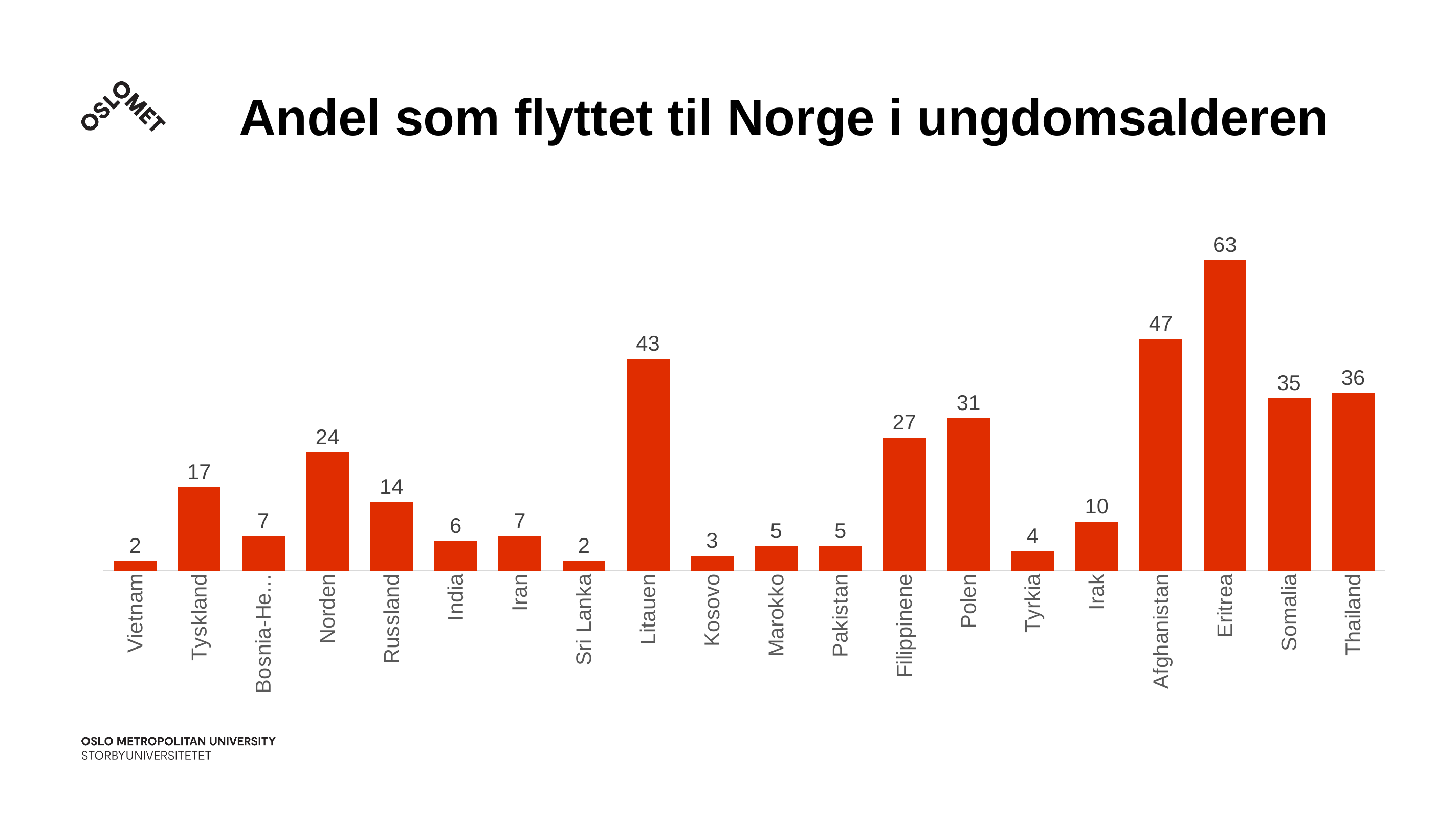
How many countries are shown on the x axis? 20 Which is larger, the value for Filippinene or the value for Polen? Polen What is the value for Litauen? 43 What is the difference between the values for Eritrea and Afghanistan? 16 Which country has the highest value? Eritrea What is the value for Afghanistan? 47 What is the title of the chart? Andel som flyttet til Norge i ungdomsalderen What colour are the bars in the chart? Red What is the value for Polen? 31 What kind of chart is shown on the slide? Bar chart What is the difference between the values for Thailand and Somalia? 1 Which is larger, the value for Norden or the value for Tyskland? Norden